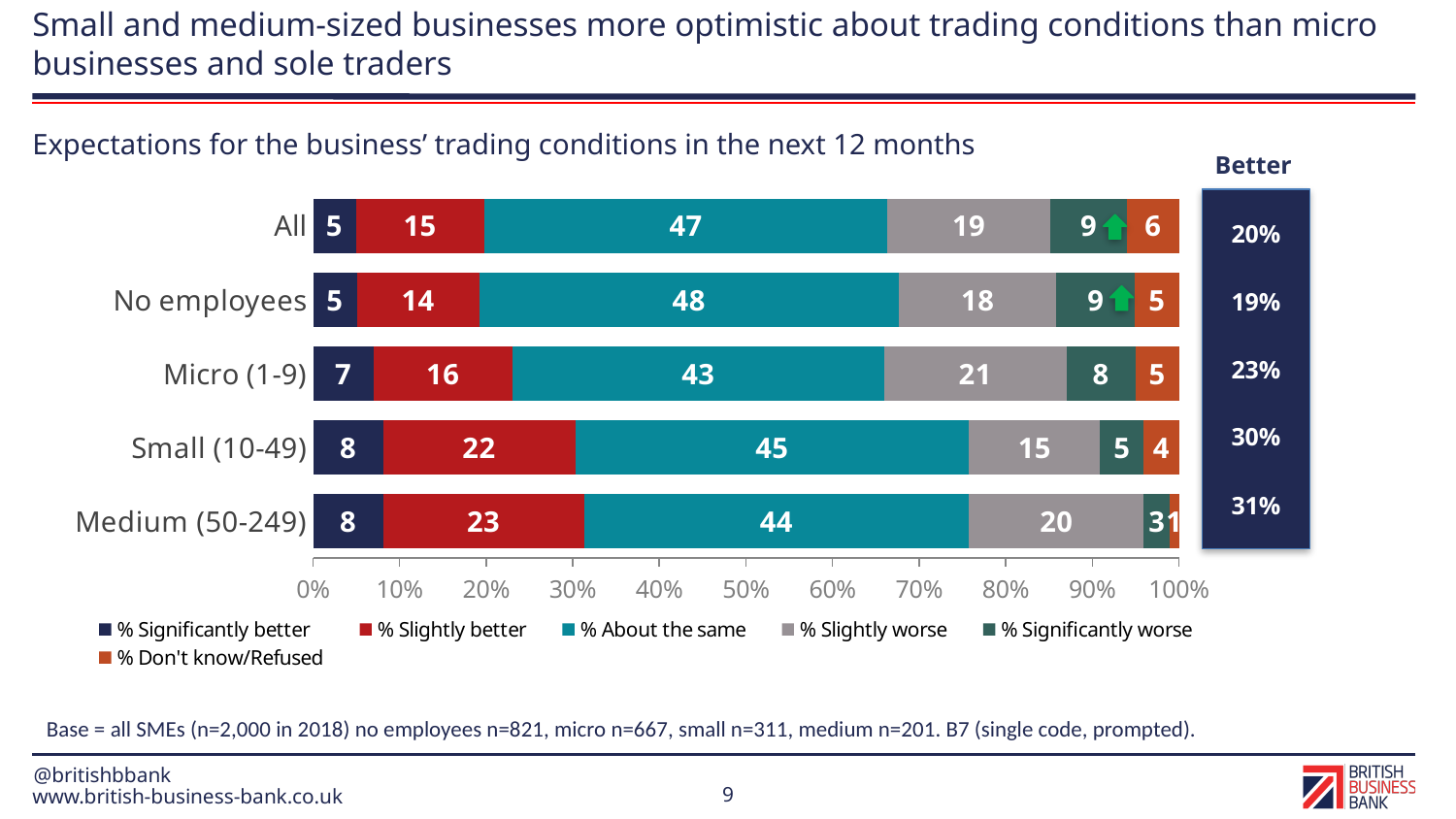
What is the title of the chart? Expectations for the business' trading conditions in the next 12 months Which has the larger value for % Significantly worse, All or Small (10-49)? All How many series does the legend list? 6 Which category has the highest value for % Slightly better? Medium (50-249) What is the 'Better' percentage shown for Small (10-49)? 30% Which category has the lowest value for % Slightly worse? Small (10-49) What is the value for % About the same for Micro (1-9)? 43 What is the difference between the % About the same values for All and Micro (1-9)? 4 What is the value for % Don't know/Refused for All? 6 What is the value for % Slightly better for Medium (50-249)? 23 What kind of chart is shown on the slide? Stacked bar chart How many categories are shown on the chart? 5